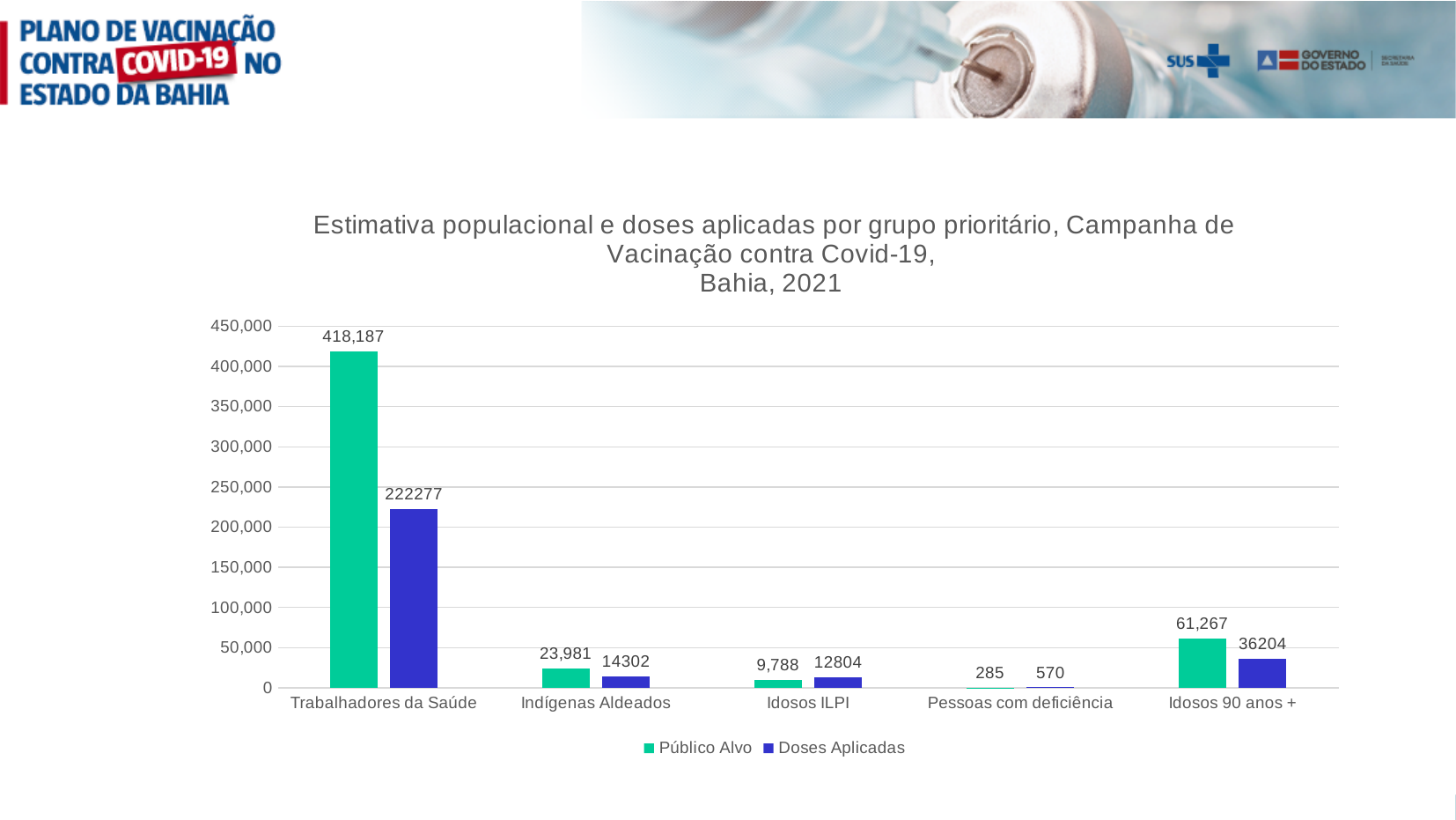
What is the Doses Aplicadas value for Trabalhadores da Saúde? 222277 Which category has the highest Público Alvo value? Trabalhadores da Saúde How many categories are shown on the x axis? 5 Which category has the lowest Doses Aplicadas value? Pessoas com deficiência For Idosos ILPI, which is larger: Público Alvo or Doses Aplicadas? Doses Aplicadas How many series does the legend list? 2 What kind of chart is shown on the slide? Bar chart What is the Público Alvo value for Pessoas com deficiência? 285 Is the Público Alvo value for Idosos 90 anos + greater or less than 50,000? greater What is the Público Alvo value for Trabalhadores da Saúde? 418,187 What is the difference between Público Alvo and Doses Aplicadas for Trabalhadores da Saúde? 195,910 What is the Doses Aplicadas value for Idosos 90 anos +? 36204